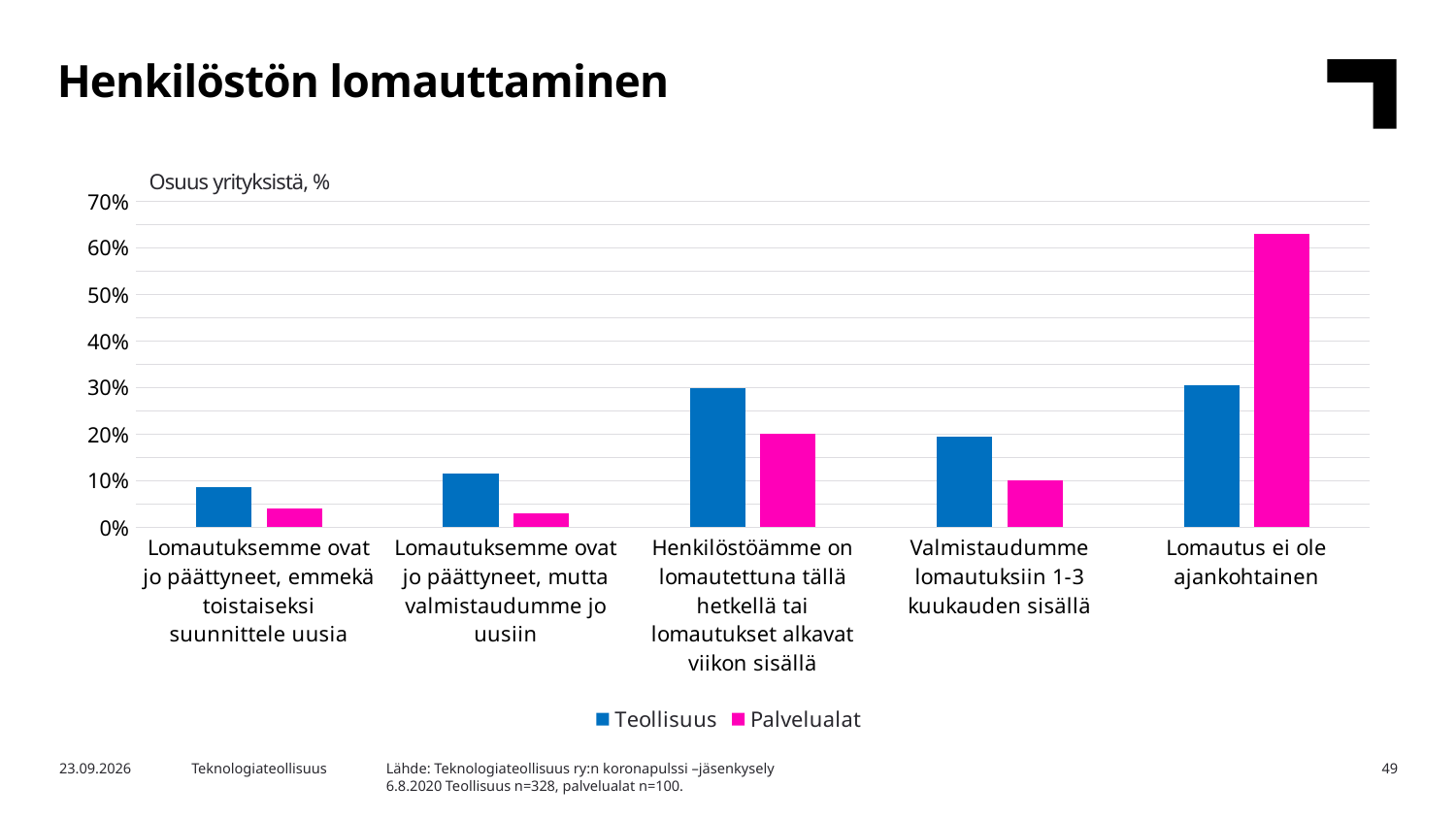
Is the Palvelualat value for 'Lomautus ei ole ajankohtainen' greater or less than 60%? greater In the category 'Henkilöstöämme on lomautettuna tällä hetkellä tai lomautukset alkavat viikon sisällä', which series has the larger value, Teollisuus or Palvelualat? Teollisuus How many categories are shown on the x axis? 5 For which category is the Teollisuus value lowest? Lomautuksemme ovat jo päättyneet, emmekä toistaiseksi suunnittele uusia Which series is shown in magenta (pink) in the chart? Palvelualat Is the Teollisuus value for 'Lomautuksemme ovat jo päättyneet, emmekä toistaiseksi suunnittele uusia' greater or less than 10%? less In the category 'Lomautus ei ole ajankohtainen', which series has the larger value, Teollisuus or Palvelualat? Palvelualat How many series does the legend list? 2 Is the Teollisuus value for 'Valmistaudumme lomautuksiin 1-3 kuukauden sisällä' greater or less than 10%? greater For which category is the Palvelualat value highest? Lomautus ei ole ajankohtainen What kind of chart is shown on the slide? Bar chart What is the label shown above the vertical axis of the chart? Osuus yrityksistä, %